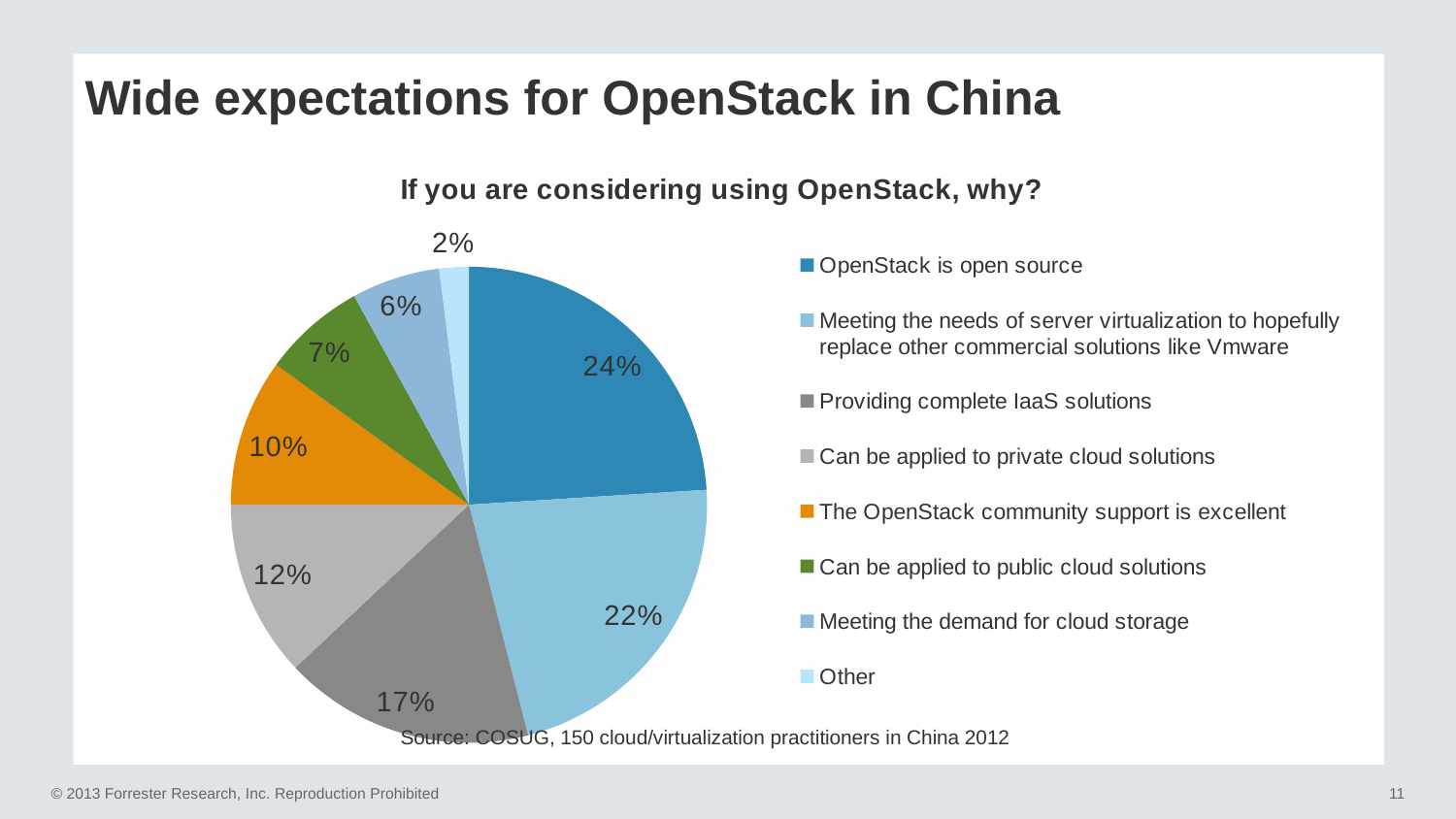
What share of respondents chose 'OpenStack is open source'? 24% What is the chart's title? If you are considering using OpenStack, why? How many slices does the pie chart have? 8 What percentage is shown for 'Other'? 2% What percentage is shown for 'Providing complete IaaS solutions'? 17% What percentage is shown for 'The OpenStack community support is excellent'? 10% Which is larger: the share for 'Can be applied to private cloud solutions' or the share for 'Can be applied to public cloud solutions'? Can be applied to private cloud solutions Which reason has the smallest share of the pie? Other What kind of chart is shown on the slide? pie chart What is the combined share of 'Can be applied to public cloud solutions' and 'Meeting the demand for cloud storage'? 13% What is the difference in percentage points between 'OpenStack is open source' and 'Meeting the needs of server virtualization to hopefully replace other commercial solutions like Vmware'? 2 percentage points Which reason has the largest share of the pie? OpenStack is open source